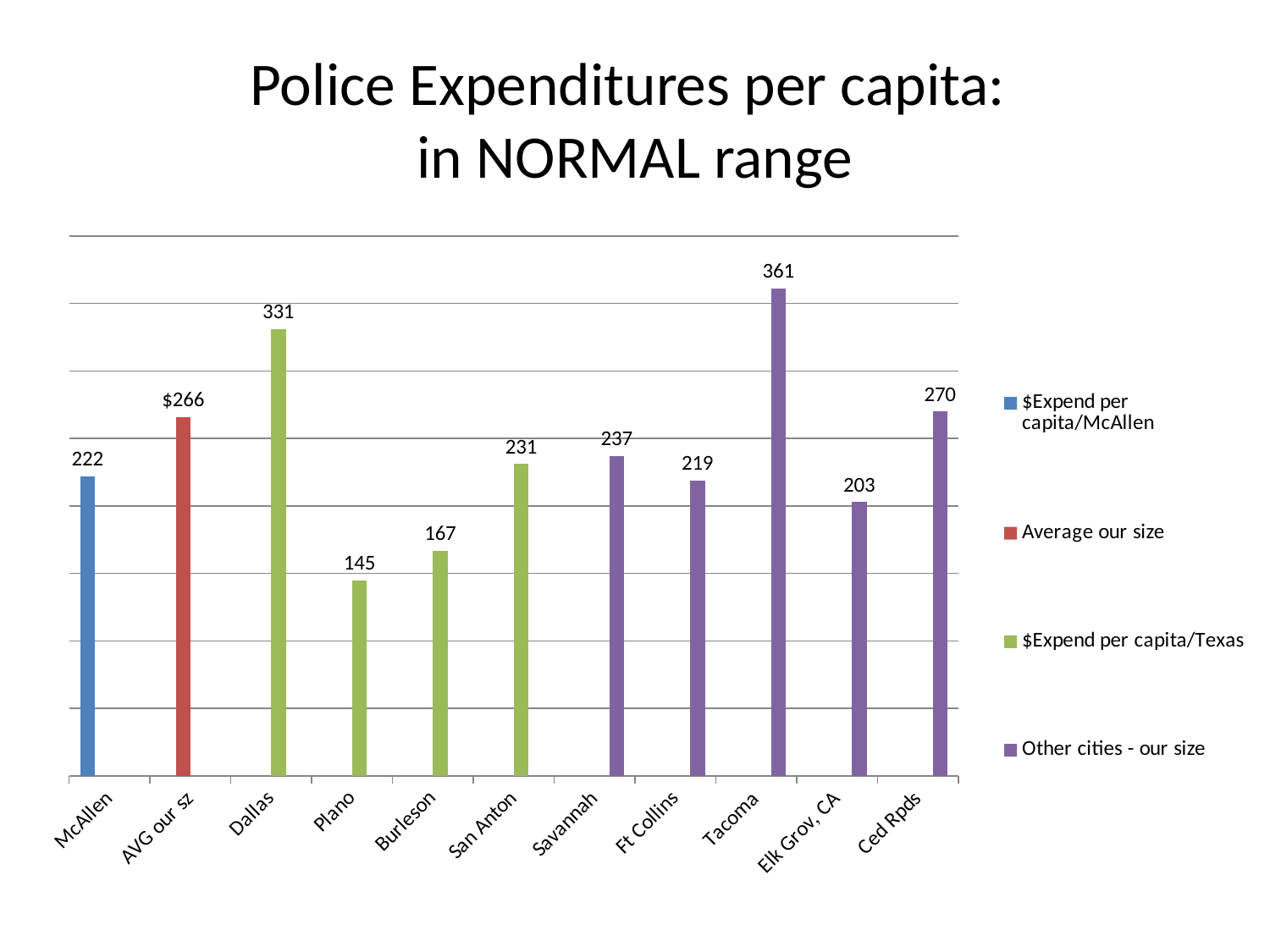
What is the difference between the values for Dallas and Plano? 186 Which city has the highest police expenditure per capita on the chart? Tacoma What value is shown for AVG our sz? $266 What kind of chart is shown on the slide? Bar chart How many series does the legend list? 4 How many cities or categories are shown on the x axis? 11 Which has a larger value, Burleson or Elk Grov, CA? Elk Grov, CA What value is shown for Tacoma? 361 Which city has the lowest police expenditure per capita on the chart? Plano What is the police expenditure per capita value shown for McAllen? 222 What is the difference between the values for Tacoma and McAllen? 139 Which has a larger value, Savannah or Ft Collins? Savannah